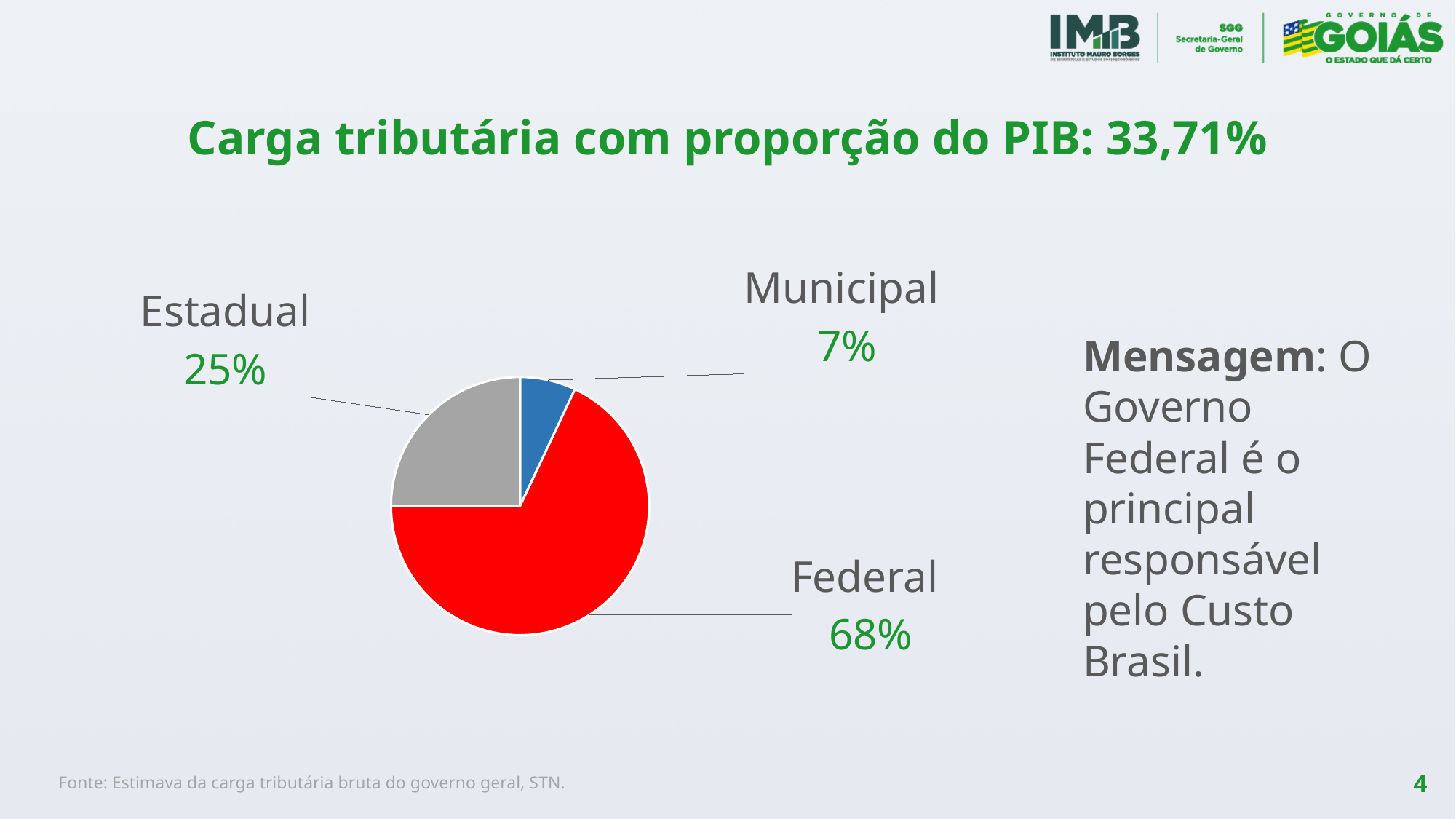
What share of the pie does Municipal have? 7% What is the title of the slide containing the pie chart? Carga tributária com proporção do PIB: 33,71% Which slice of the pie is the smallest? Municipal What colour is the Federal slice of the pie? Red How many slices does the pie chart have? 3 Which slice of the pie is the largest? Federal What type of chart is shown on the slide? Pie chart What is the difference in percentage points between the Estadual and Municipal slices? 18 Which is larger, the Estadual slice or the Municipal slice? Estadual What is the difference in percentage points between the Federal and Estadual slices? 43 What share of the pie does Estadual have? 25% What share of the pie does Federal have? 68%